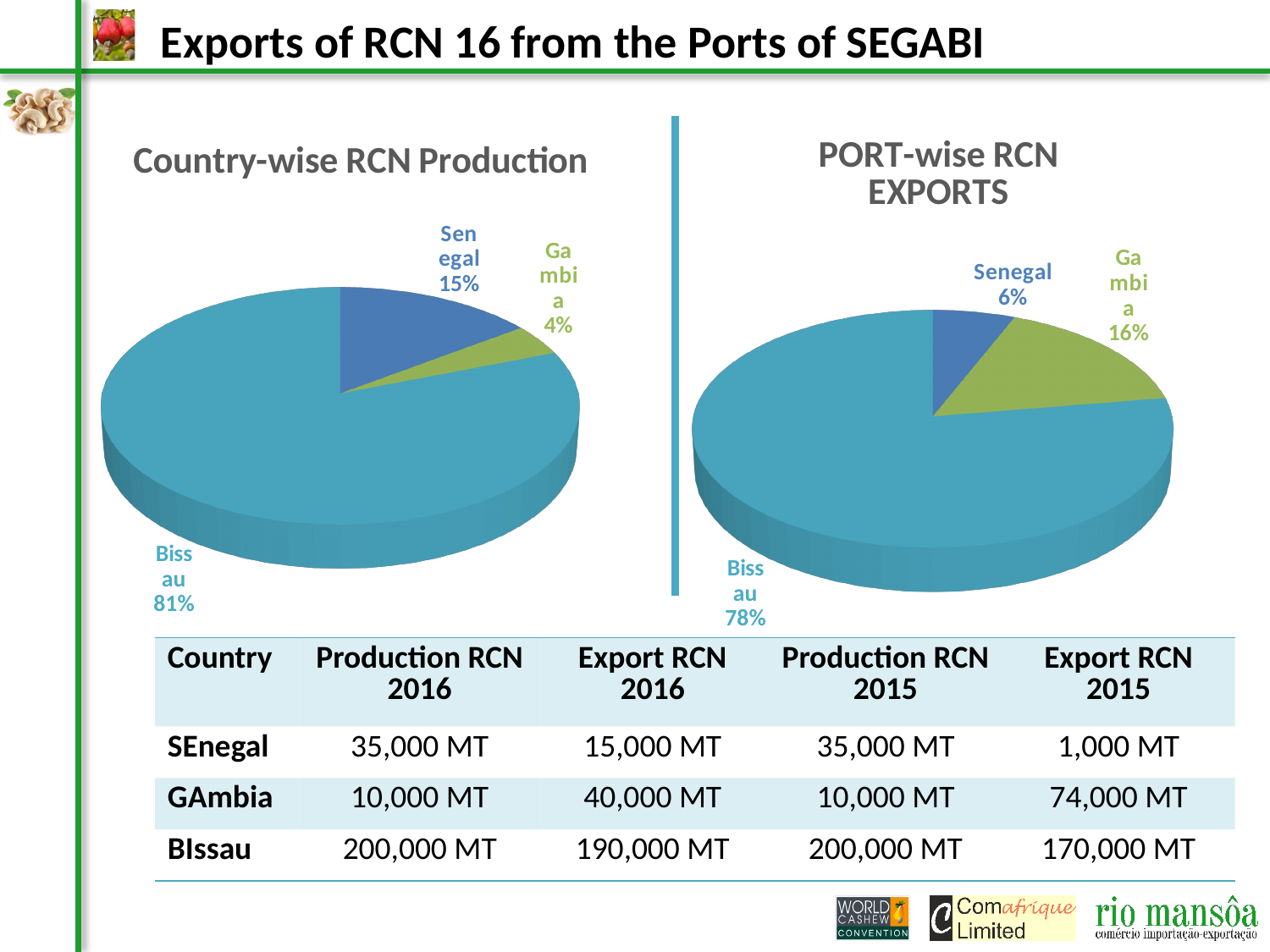
In the PORT-wise RCN EXPORTS chart, which port has the largest slice? Bissau In the Country-wise RCN Production chart, which country has the smallest slice? Gambia In the Country-wise RCN Production chart, what share does Senegal have? 15% In the Country-wise RCN Production chart, what share does Gambia have? 4% In the PORT-wise RCN EXPORTS chart, what share does Bissau have? 78% In the Country-wise RCN Production chart, what is the difference between Senegal's share and Gambia's share? 11% How many slices does the PORT-wise RCN EXPORTS chart have? 3 In the PORT-wise RCN EXPORTS chart, which is larger, Gambia or Senegal? Gambia What type of chart is the Country-wise RCN Production chart? Pie chart